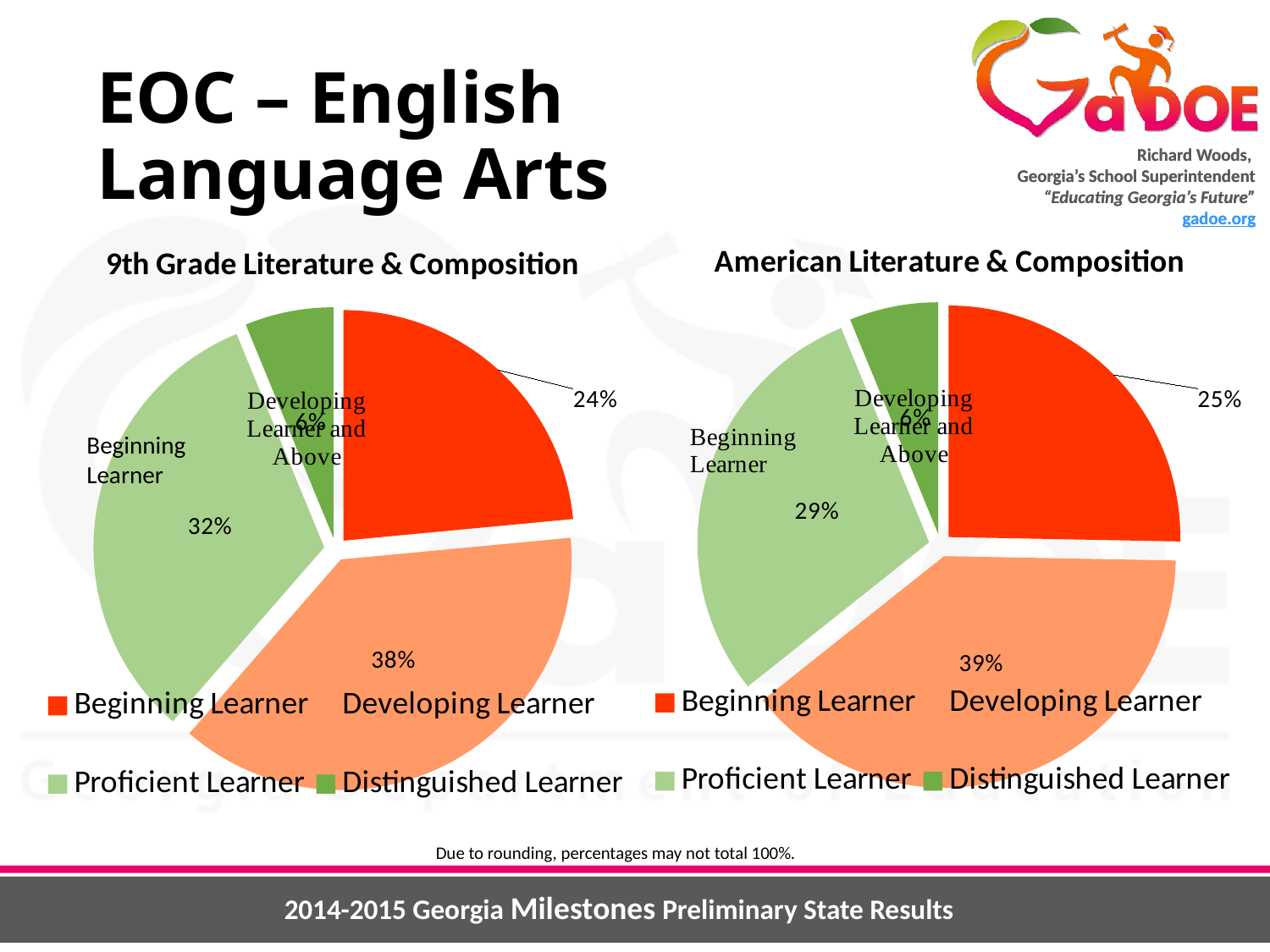
In the American Literature & Composition chart, what percentage of students are Distinguished Learners? 6% In the American Literature & Composition chart, what percentage of students are Proficient Learners? 29% In the 9th Grade Literature & Composition chart, what percentage of students are Developing Learners? 38% In the American Literature & Composition chart, what is the difference between the Developing Learner and Beginning Learner percentages? 14 percentage points In the 9th Grade Literature & Composition chart, what colour represents Beginning Learner? Red What type of chart is used for 9th Grade Literature & Composition? Pie chart In the American Literature & Composition chart, which category has the smallest share? Distinguished Learner In the 9th Grade Literature & Composition chart, what percentage of students are Beginning Learners? 24% In the 9th Grade Literature & Composition chart, which category has the largest share? Developing Learner In the 9th Grade Literature & Composition chart, what is the difference between the Developing Learner and Proficient Learner percentages? 6 percentage points How many categories does the legend of the American Literature & Composition chart list? 4 Is the Proficient Learner share larger in the 9th Grade Literature & Composition chart or the American Literature & Composition chart? 9th Grade Literature & Composition